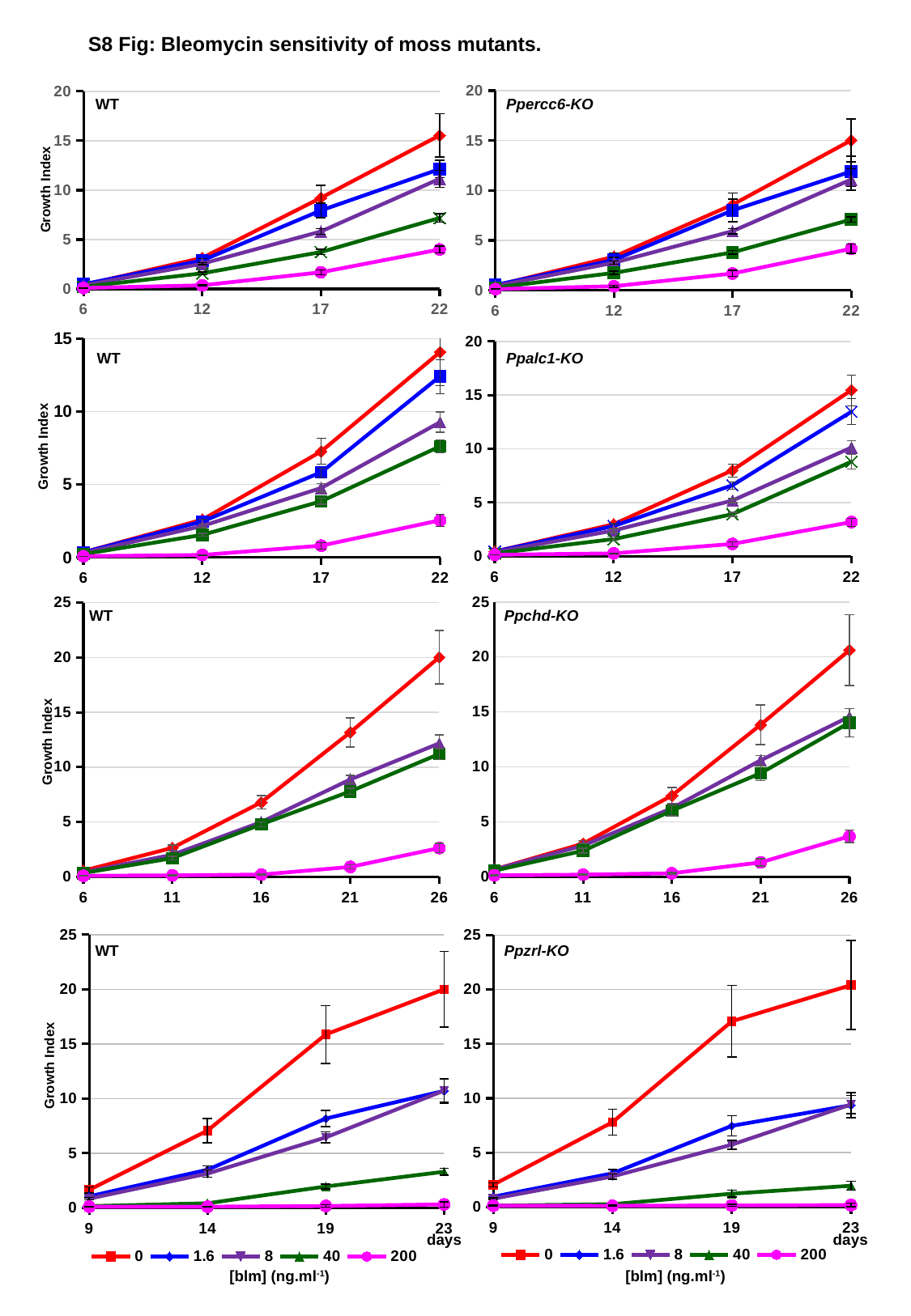
In the Ppercc6-KO chart, is the growth index for the 0 series at day 22 greater or less than 10? greater In the Ppzrl-KO chart, which series has the lowest growth index at day 23? 200 How many series does the legend list for the Ppzrl-KO chart? 5 What kind of chart is used in the top-left WT panel? line chart How many time points are plotted along the x axis of the Ppercc6-KO chart? 4 In the Ppalc1-KO chart, which series has the highest growth index at day 22? 0 How many time points are plotted along the x axis of the Ppchd-KO chart? 5 In the Ppchd-KO chart, is the growth index for the 0 series at day 26 greater or less than 15? greater What is the legend title shown below the charts? [blm] (ng.ml-1) In the Ppchd-KO chart, which series has the larger growth index at day 26, 0 or 40? 0 In the bottom-left WT chart, is the growth index for the 200 series at day 23 greater or less than 5? less In the Ppzrl-KO chart, does the growth index for the 0 ng/ml series rise or fall from day 9 to day 23? rise